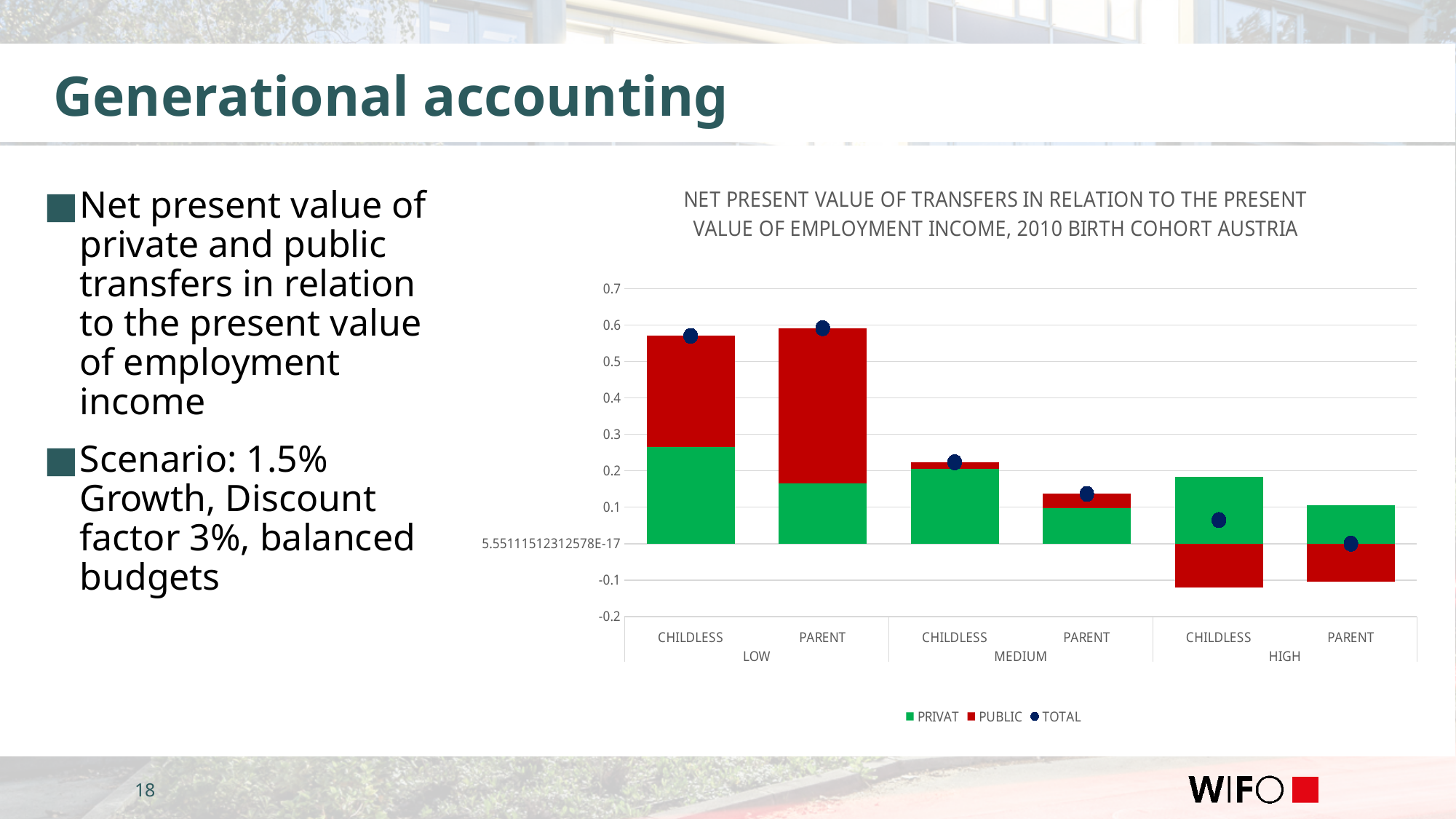
How many series does the legend list? 3 Is the PRIVAT value for LOW CHILDLESS greater or less than 0.2? greater Is the TOTAL value for LOW PARENT greater or less than 0.5? greater Which income groups are shown along the x axis? LOW, MEDIUM, HIGH Is the PUBLIC value for HIGH CHILDLESS greater or less than 0? less What are the three series named in the legend? PRIVAT, PUBLIC, TOTAL How many bars (categories) are plotted in the chart? 6 Within the LOW income group, is the PUBLIC value larger for CHILDLESS or for PARENT? PARENT Do the TOTAL values rise or fall when moving from the LOW to the HIGH income group? fall Which category has the lowest TOTAL value? HIGH PARENT What kind of chart is shown on the slide? Stacked bar chart with a line/dot series for totals